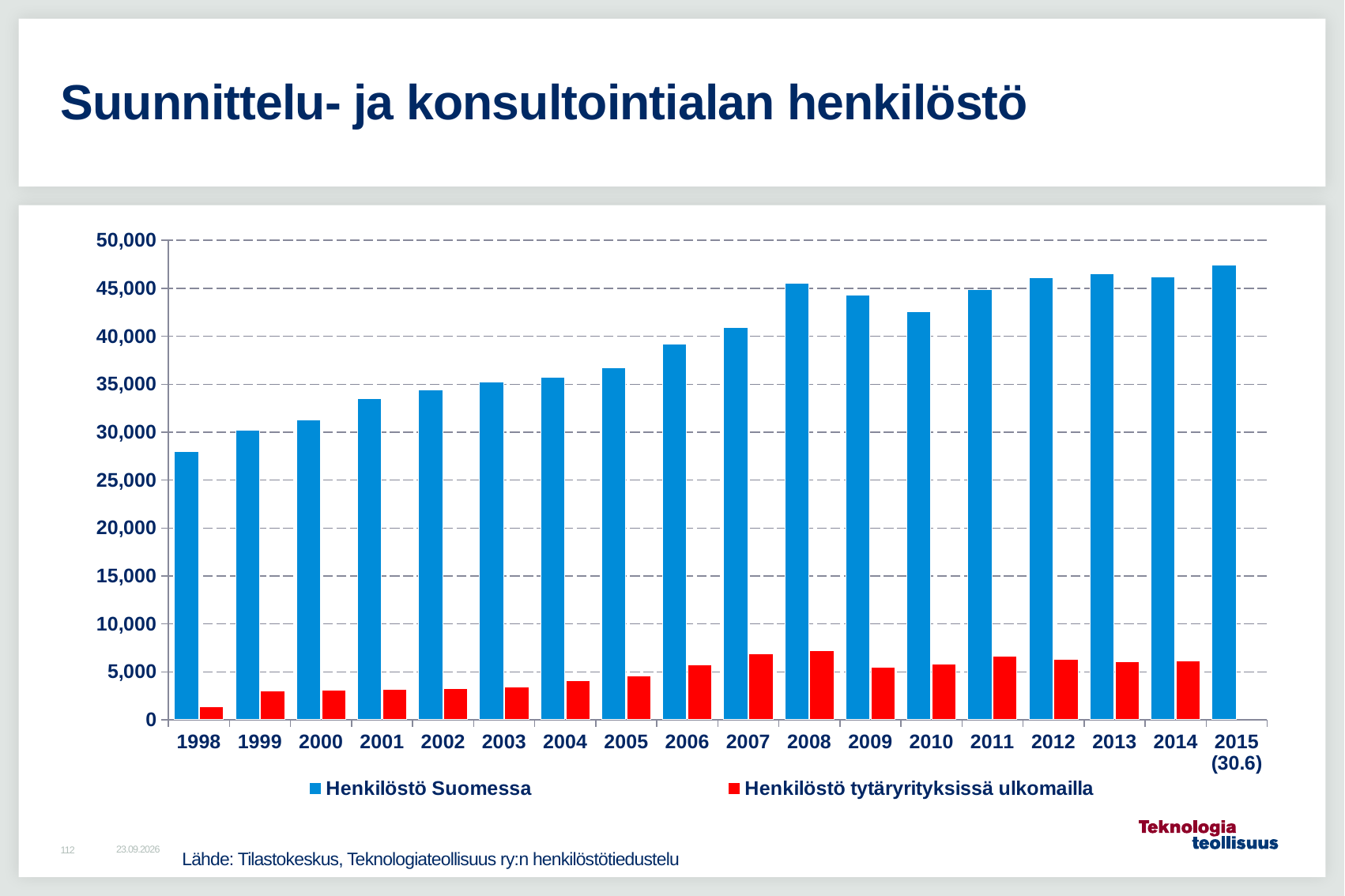
What kind of chart is shown on the slide? Bar chart Is the value for Henkilöstö Suomessa in 1998 greater or less than 30,000? less How many series does the legend list? 2 Which is larger for Henkilöstö Suomessa, the value in 2008 or the value in 2009? 2008 Which year has the highest value for Henkilöstö Suomessa? 2015 (30.6) What colour are the bars for Henkilöstö tytäryrityksissä ulkomailla? Red Is the value for Henkilöstö tytäryrityksissä ulkomailla in 2008 greater or less than 5,000? greater Which year has the lowest value for Henkilöstö Suomessa? 1998 How many years are shown on the x axis? 18 Does the value for Henkilöstö Suomessa rise or fall from 1998 to 2008? rise Which year has the lowest value for Henkilöstö tytäryrityksissä ulkomailla? 1998